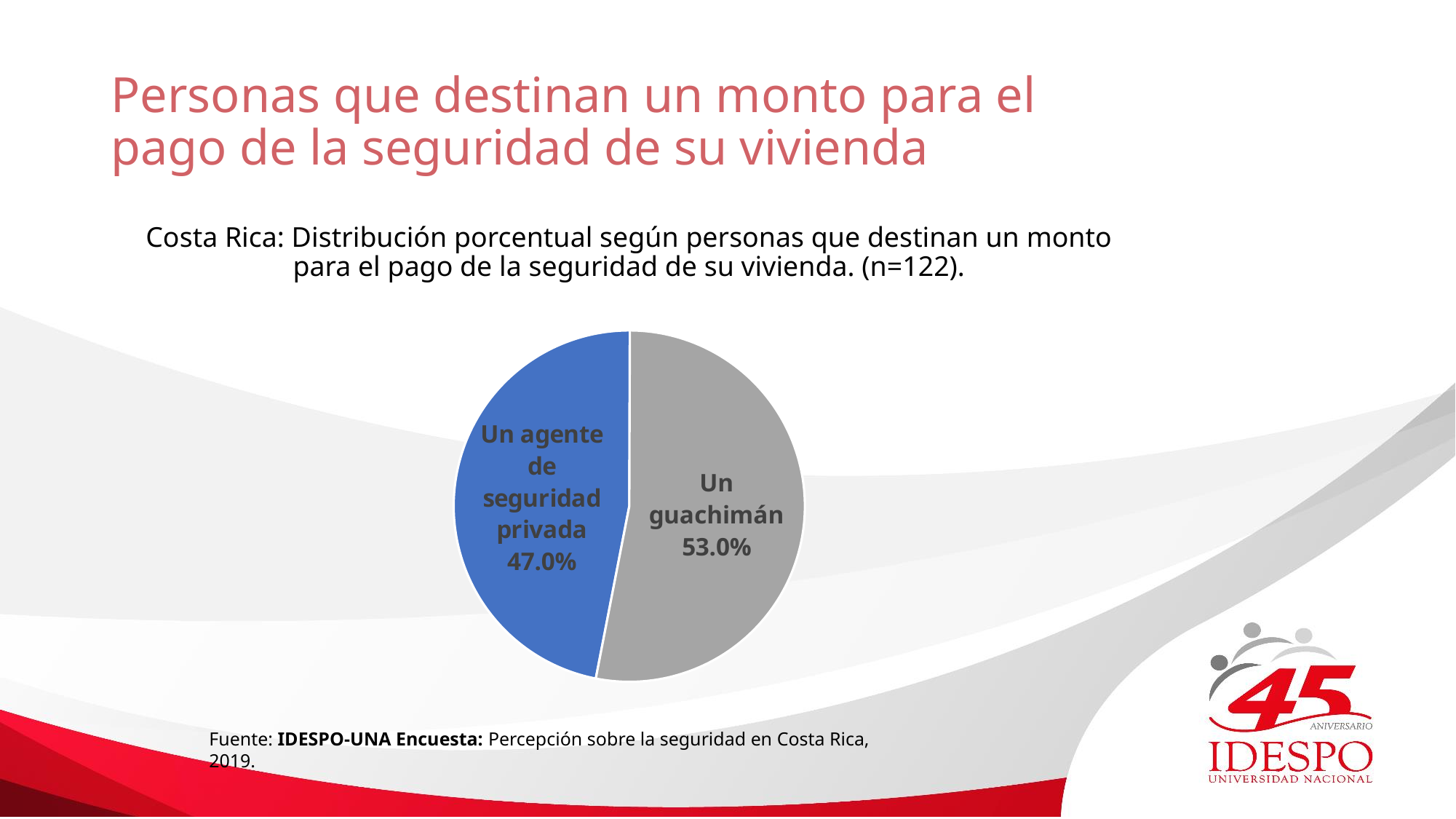
What kind of chart is shown on the slide? Pie chart What percentage of the pie corresponds to "Un guachimán"? 53.0% Which category has the smallest share of the pie? Un agente de seguridad privada What percentage of the pie corresponds to "Un agente de seguridad privada"? 47.0% What is the sample size (n) stated in the chart title? 122 What colour is the slice for "Un agente de seguridad privada"? Blue How many slices does the pie chart have? 2 Which category has the largest share of the pie? Un guachimán What is the difference in percentage points between "Un guachimán" and "Un agente de seguridad privada"? 6.0 percentage points Which is larger: the share for "Un guachimán" or the share for "Un agente de seguridad privada"? Un guachimán